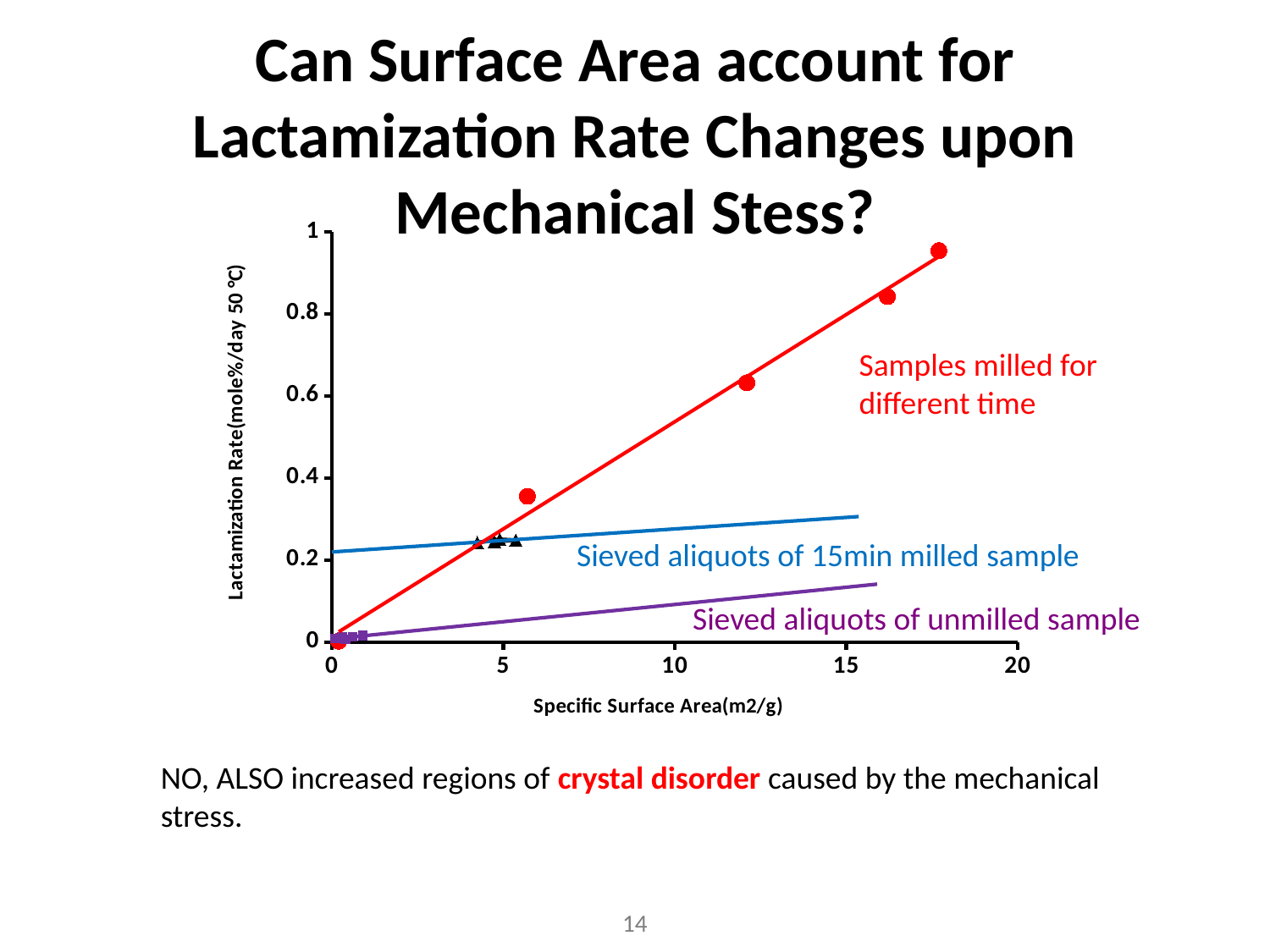
Which series has the steepest trend line: samples milled for different time, sieved aliquots of 15min milled sample, or sieved aliquots of unmilled sample? Samples milled for different time Are the values for the sieved aliquots of the 15min milled sample greater or less than 0.2? greater How many red circle data points (samples milled for different time) are plotted? 5 What is the title of the x axis of the chart? Specific Surface Area(m2/g) How many data series are plotted on the chart? 3 Do the values for the samples milled for different time rise or fall as specific surface area increases? rise What kind of chart is shown on the slide? scatter chart What is the title of the y axis of the chart? Lactamization Rate(mole%/day 50 ℃) Which series has the lowest lactamization rate values: sieved aliquots of 15min milled sample or sieved aliquots of unmilled sample? Sieved aliquots of unmilled sample What is the maximum value shown on the x axis? 20 Is the highest value for the samples milled for different time greater or less than 0.8? greater Are the values for the sieved aliquots of the 15min milled sample greater or less than 0.4? less